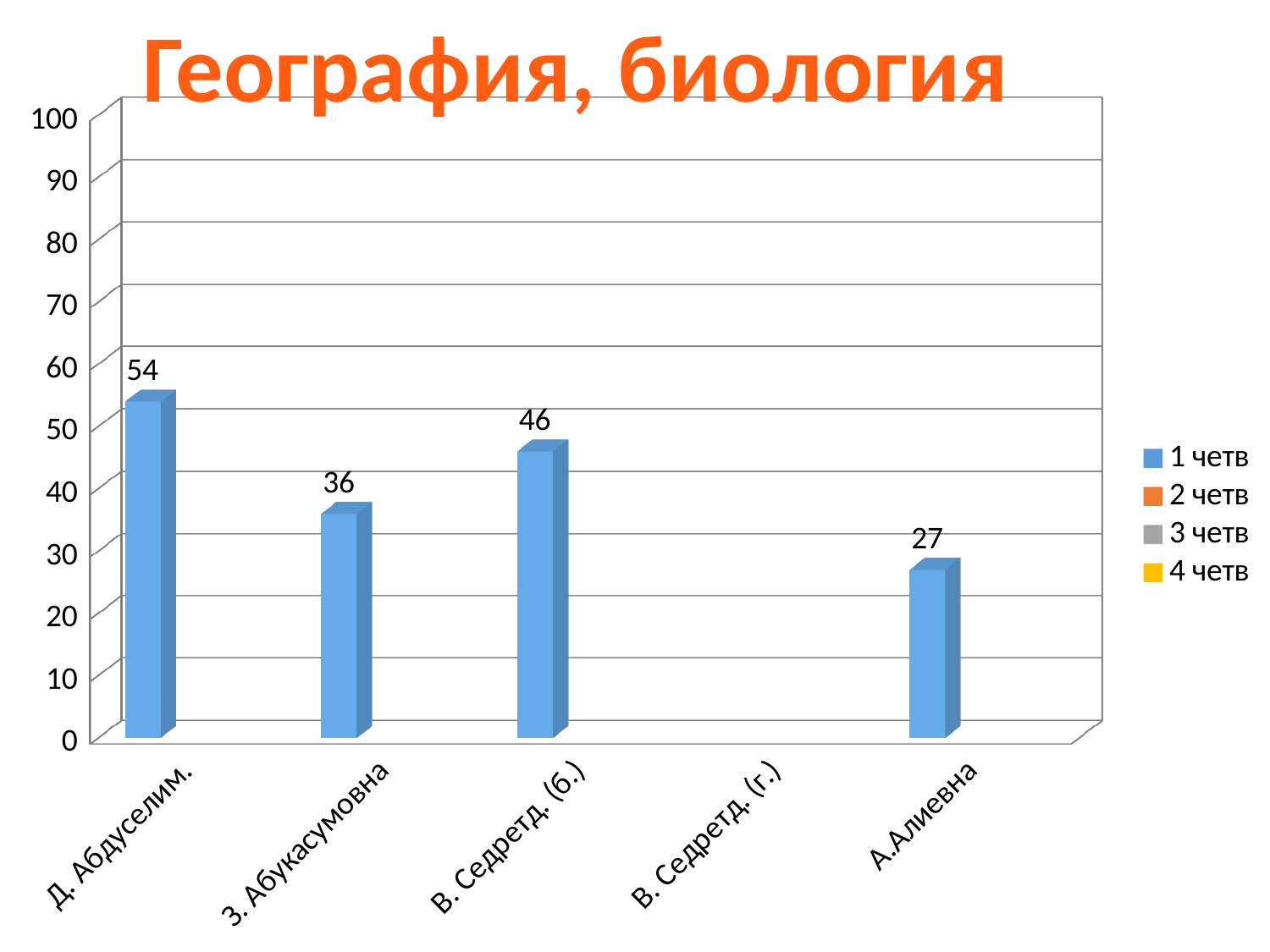
Among the categories with a plotted bar, which has the lowest value? А.Алиевна How many categories are shown on the x axis? 5 How many series does the legend list? 4 What is the value for В. Седретд. (б.) in the 1 четв series? 46 What is the difference between the values for Д. Абдуселим. and А.Алиевна? 27 What is the title of the chart? География, биология What kind of chart is shown on the slide? Bar chart What is the value for З. Абукасумовна in the 1 четв series? 36 Which is larger, the value for З. Абукасумовна or the value for В. Седретд. (б.)? В. Седретд. (б.) What is the value for Д. Абдуселим. in the 1 четв series? 54 Which category has the highest value in the 1 четв series? Д. Абдуселим. What is the value for А.Алиевна in the 1 четв series? 27